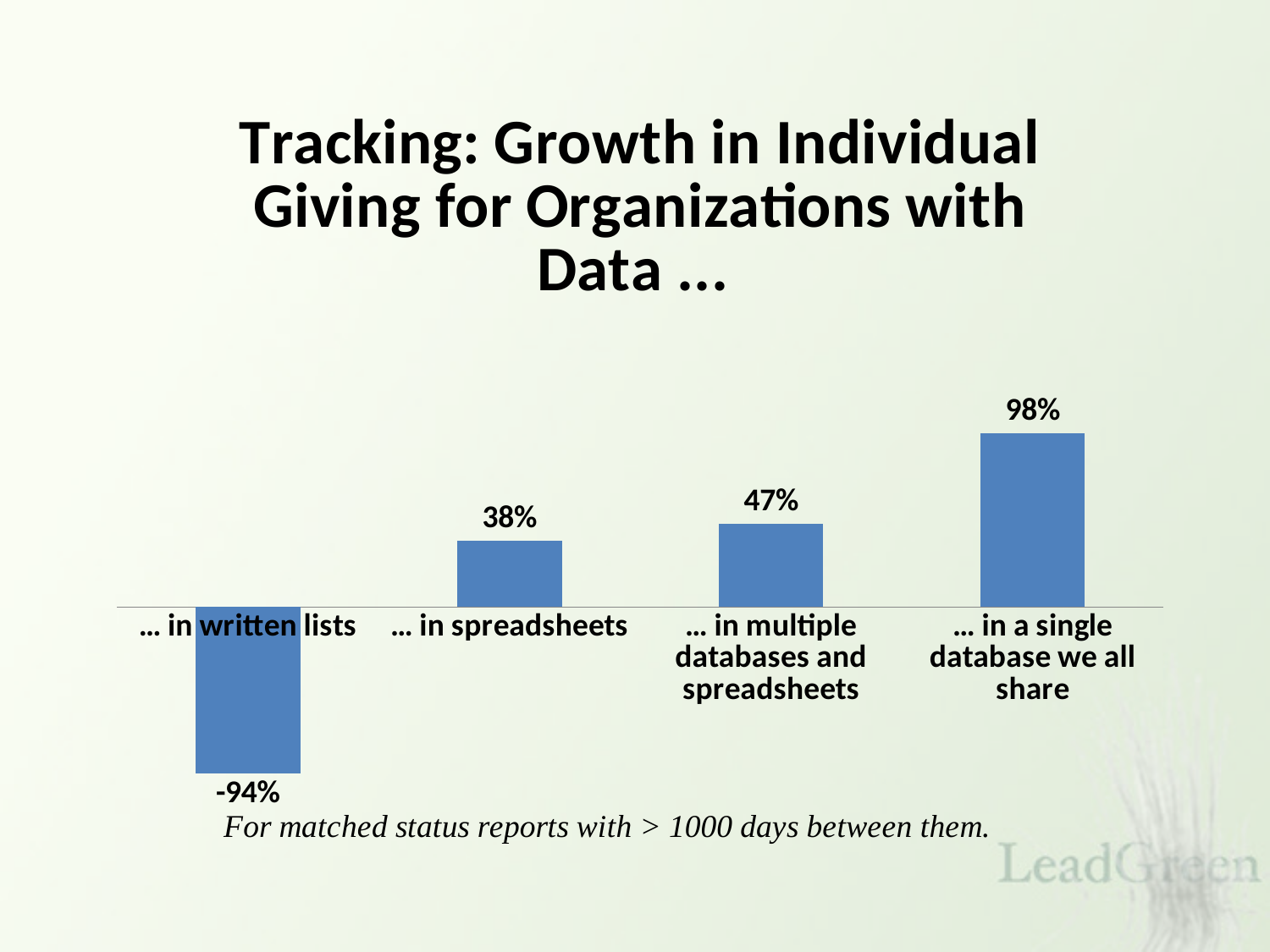
What kind of chart is shown on the slide? Bar chart What is the growth in individual giving for organizations with data in spreadsheets? 38% Which category has the lowest growth in individual giving? ... in written lists What is the growth in individual giving for organizations with data in written lists? -94% How many categories are shown in the chart? 4 Which category has the highest growth in individual giving? ... in a single database we all share What is the difference between the growth for multiple databases and spreadsheets and the growth for spreadsheets? 9% What is the difference between the growth for a single database we all share and the growth for spreadsheets? 60% What is the growth in individual giving for organizations with data in a single database we all share? 98% Which is larger: the growth for multiple databases and spreadsheets or the growth for spreadsheets? ... in multiple databases and spreadsheets What is the growth in individual giving for organizations with data in multiple databases and spreadsheets? 47% Do the values rise or fall from left to right across the categories? Rise